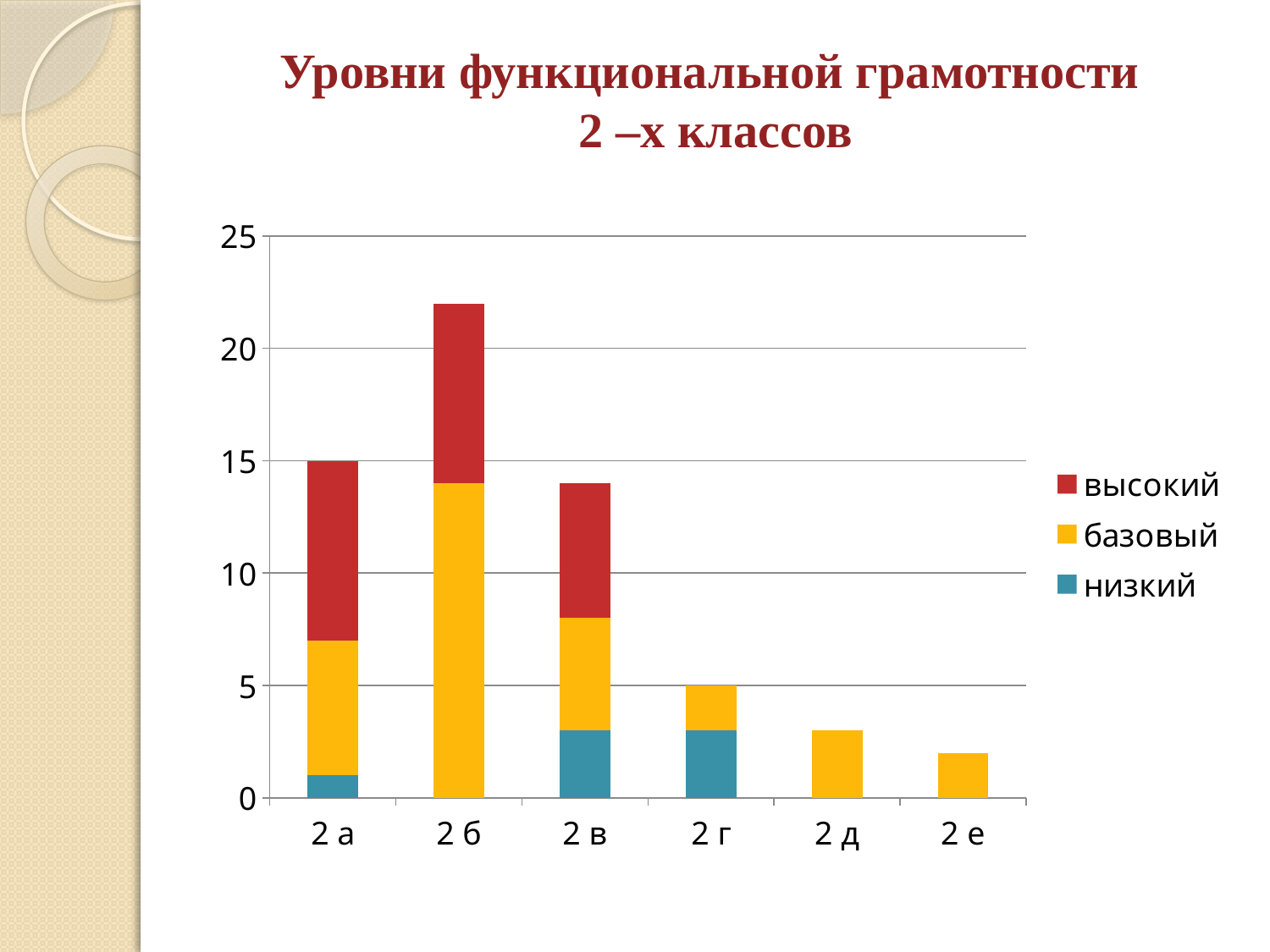
How many series does the legend list? 3 What is the total height of the stacked bar for class 2 а? 15 Which class has the tallest stacked bar? 2 б What kind of chart is shown on the slide? stacked bar chart Which series is shown in red in the legend? высокий What is the total height of the stacked bar for class 2 г? 5 Which class has a larger total, 2 в or 2 г? 2 в Which class has the shortest stacked bar? 2 е Is the total for class 2 б greater or less than 20? greater What is the title of the chart? Уровни функциональной грамотности 2 –х классов How many classes are shown along the x axis? 6 Is the total for class 2 д greater or less than 5? less